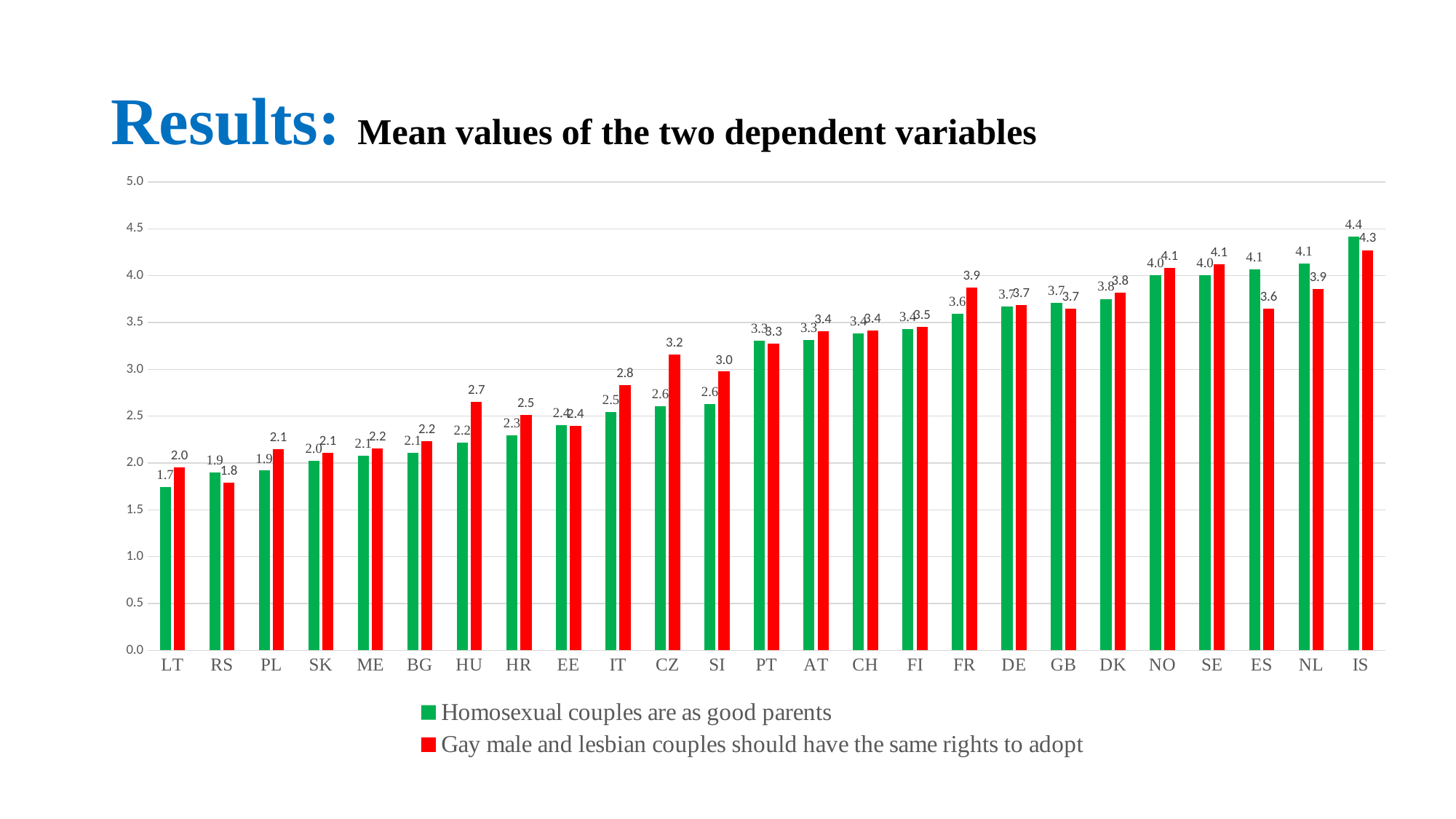
Do the values for 'Homosexual couples are as good parents' generally rise or fall from LT to IS along the x axis? Rise How many series does the legend list? 2 For CZ, what is the difference between the 'same rights to adopt' value and the 'as good parents' value? 0.6 Which country has the lowest value for 'Homosexual couples are as good parents'? LT What kind of chart is shown on the slide? Bar chart How many countries are shown on the x axis? 25 What is the value for IS in the series 'Homosexual couples are as good parents'? 4.4 What is the value for ES in the series 'Gay male and lesbian couples should have the same rights to adopt'? 3.6 Which country has the highest value for 'Homosexual couples are as good parents'? IS Is the value for FR in the 'same rights to adopt' series greater or less than 3.5? greater For ES, which series has the larger value: 'Homosexual couples are as good parents' or 'Gay male and lesbian couples should have the same rights to adopt'? Homosexual couples are as good parents What is the value for HU in the series 'Gay male and lesbian couples should have the same rights to adopt'? 2.7